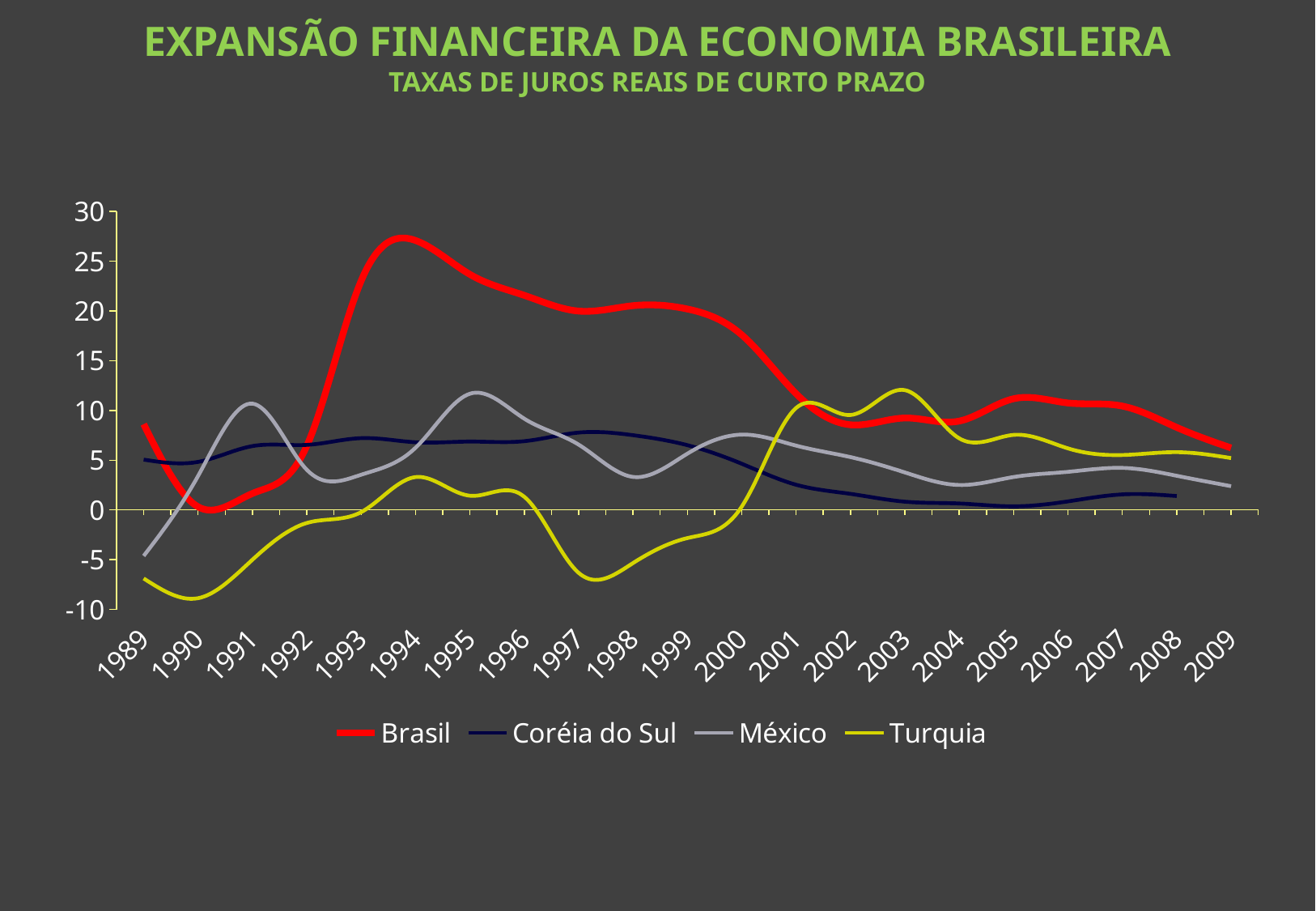
Which series reaches the highest value anywhere on the chart? Brasil What colour is the Brasil line in the legend? red Is the value for México in 1995 greater or less than 10? greater Is the value for Brasil in 1994 greater or less than 25? greater Is the value for Turquia in 1990 greater or less than -5? less What kind of chart is shown on the slide? line chart In 1994, which is larger: the value for Brasil or the value for México? Brasil How many years are shown along the x axis? 21 How many series does the legend list? 4 Which series has the lowest value in 1997? Turquia Does the Brasil line rise or fall between 1994 and 2000? fall